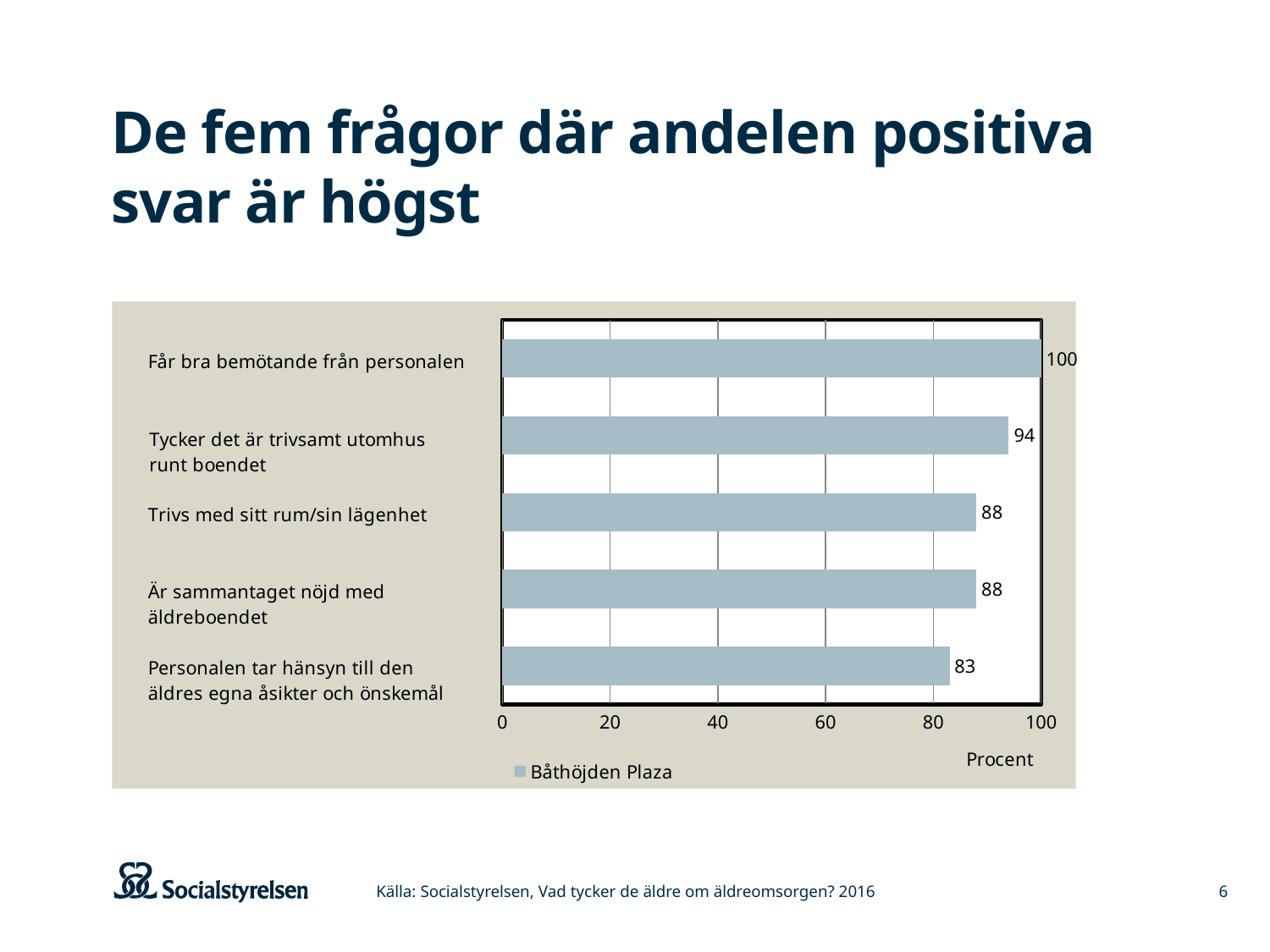
Which category has the lowest value? Personalen tar hänsyn till den äldres egna åsikter och önskemål How many series does the legend list? 1 What is the value for "Personalen tar hänsyn till den äldres egna åsikter och önskemål"? 83 What kind of chart is shown on the slide? Bar chart What is the value for "Får bra bemötande från personalen"? 100 What is the difference between the values for "Får bra bemötande från personalen" and "Personalen tar hänsyn till den äldres egna åsikter och önskemål"? 17 What is the value for "Trivs med sitt rum/sin lägenhet"? 88 How many categories are shown in the chart? 5 What is the value for "Tycker det är trivsamt utomhus runt boendet"? 94 Which is larger: the value for "Tycker det är trivsamt utomhus runt boendet" or for "Är sammantaget nöjd med äldreboendet"? Tycker det är trivsamt utomhus runt boendet Which category has the highest value? Får bra bemötande från personalen What is the name of the series shown in the legend? Båthöjden Plaza